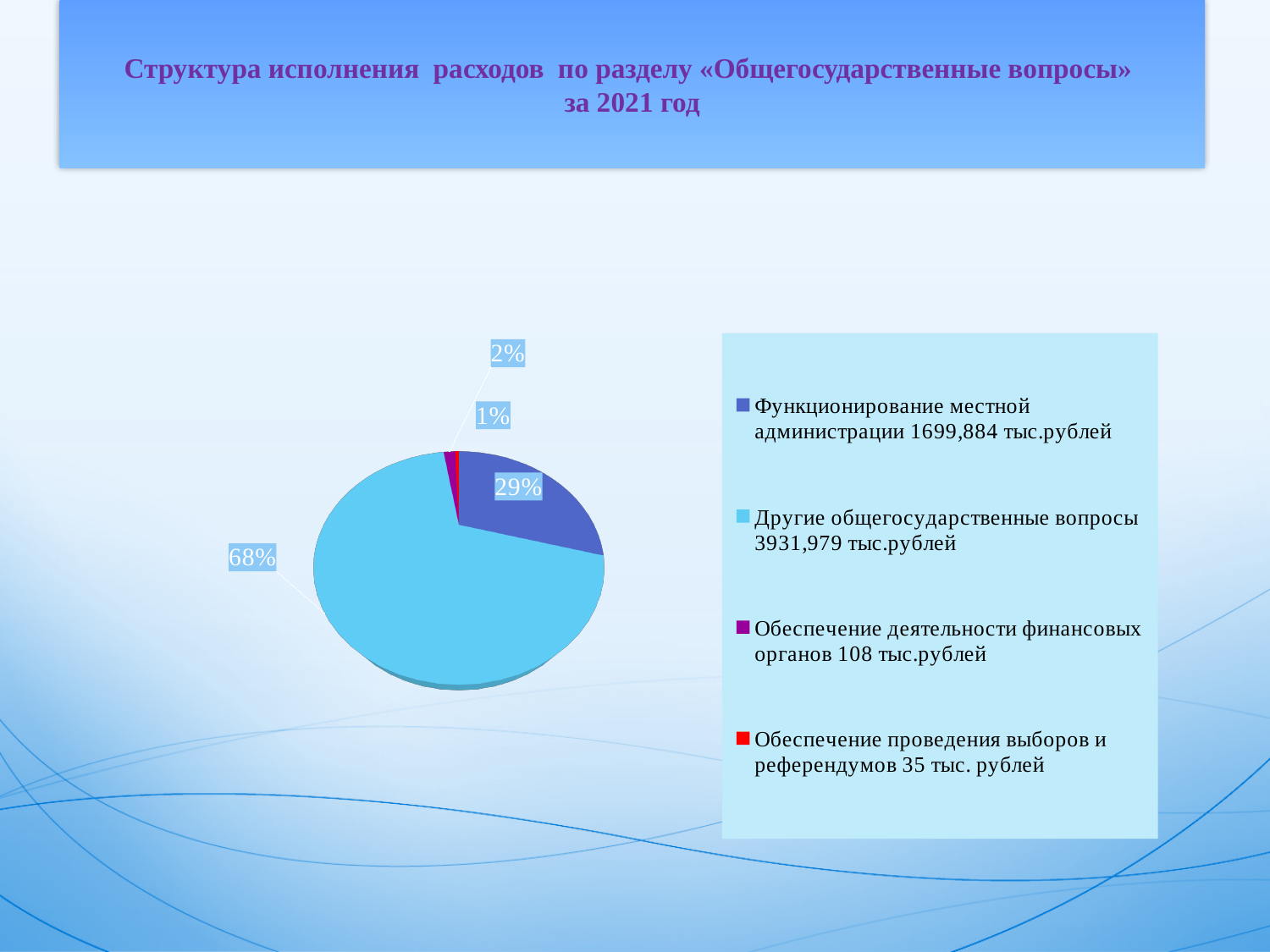
What amount in thousand rubles does the legend give for «Обеспечение деятельности финансовых органов»? 108 тыс.рублей What kind of chart is shown on the slide? pie chart Which category has the largest slice of the pie? Другие общегосударственные вопросы What share of the pie does «Обеспечение проведения выборов и референдумов» take? 1% Which category has the smallest slice of the pie? Обеспечение проведения выборов и референдумов Which is larger: the share for «Функционирование местной администрации» or the share for «Другие общегосударственные вопросы»? Другие общегосударственные вопросы What share of the pie does «Функционирование местной администрации» take? 29% How many entries does the legend list? 4 How many slices does the pie chart have? 4 What share of the pie does «Другие общегосударственные вопросы» take? 68% What is the difference in percentage points between the «Другие общегосударственные вопросы» slice and the «Функционирование местной администрации» slice? 39%